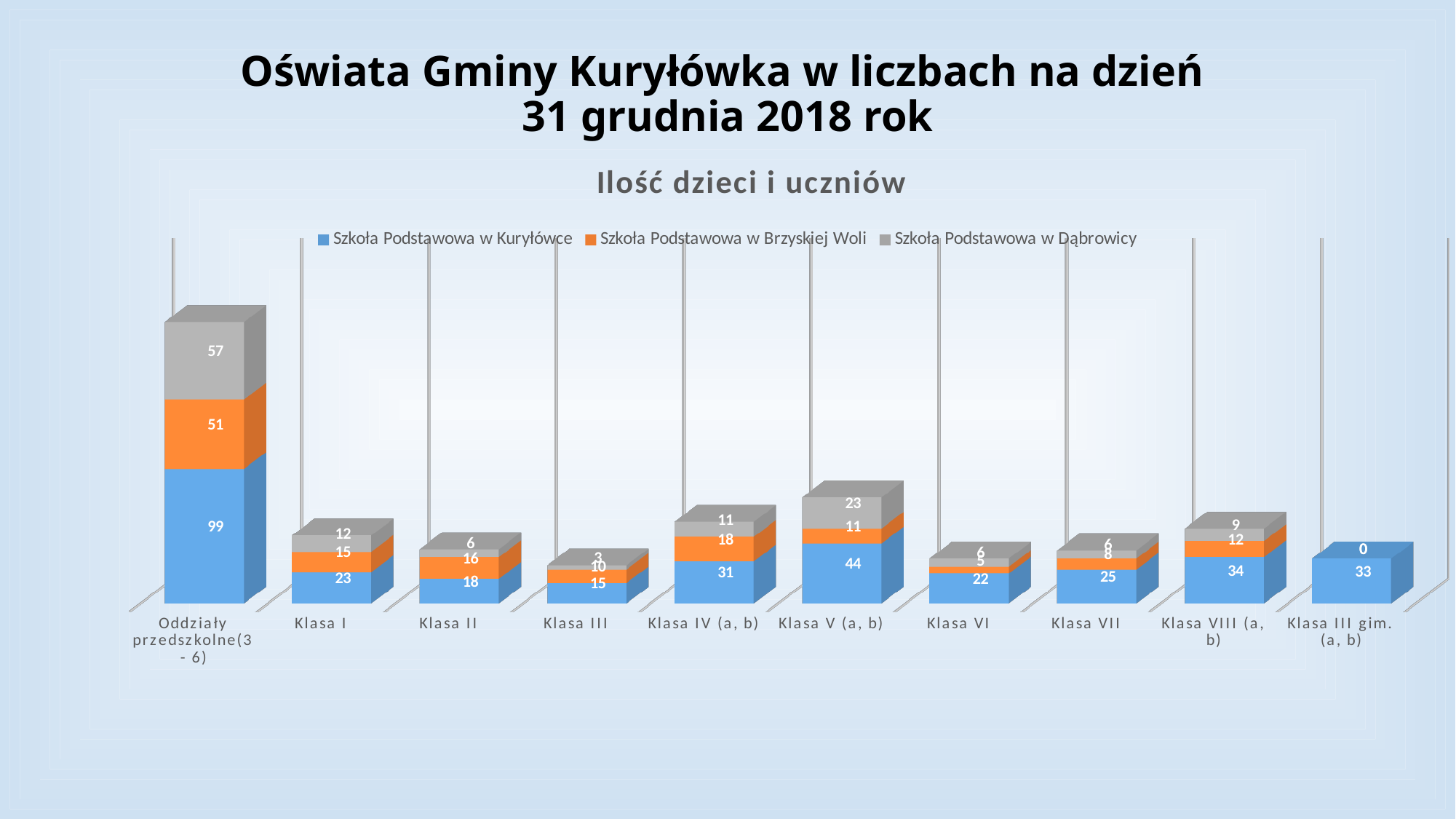
What is the total of the stacked bar for Oddziały przedszkolne(3 - 6)? 207 What kind of chart is shown on the slide? Bar chart How many series does the legend list? 3 How many categories are shown along the x axis? 10 For Szkoła Podstawowa w Kuryłówce, which is larger: Klasa VIII (a, b) or Klasa III gim. (a, b)? Klasa VIII (a, b) What is the value for Szkoła Podstawowa w Kuryłówce in the category Oddziały przedszkolne(3 - 6)? 99 What is the value for Szkoła Podstawowa w Dąbrowicy in Klasa V (a, b)? 23 What is the difference between the Szkoła Podstawowa w Kuryłówce values for Klasa V (a, b) and Klasa IV (a, b)? 13 Which category has the highest value for Szkoła Podstawowa w Kuryłówce? Oddziały przedszkolne(3 - 6) What is the title of the chart? Ilość dzieci i uczniów What is the value for Szkoła Podstawowa w Brzyskiej Woli in Klasa IV (a, b)? 18 What is the total of the stacked bar for Klasa I? 50